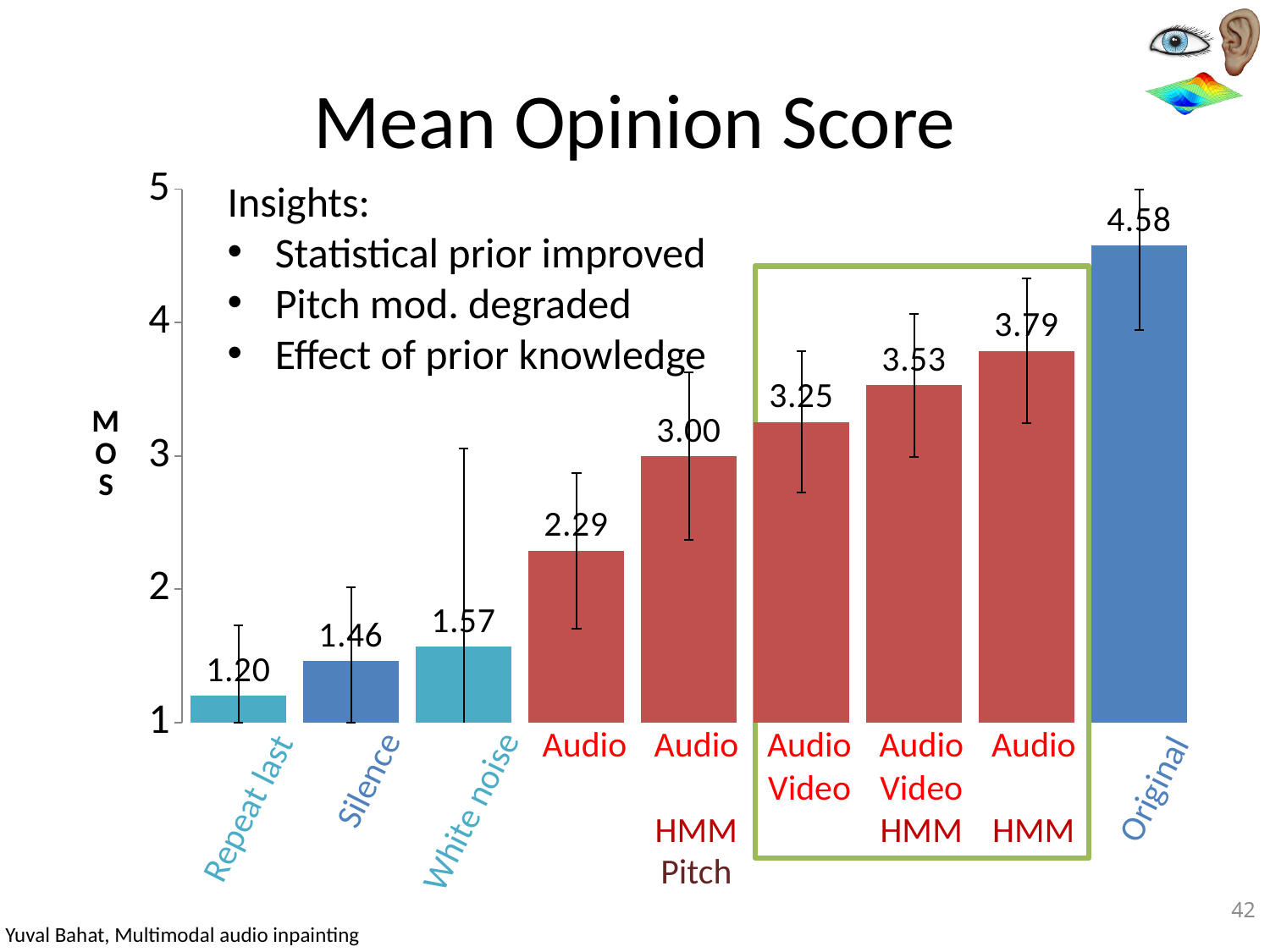
Which category has the lowest Mean Opinion Score? Repeat last Which category has the highest Mean Opinion Score? Original What is the difference between the Mean Opinion Score for Original and for Audio HMM? 0.79 Which has a higher Mean Opinion Score, Audio Video or Audio HMM Pitch? Audio Video How many bars are shown in the chart? 9 What kind of chart is shown on the slide? bar chart What is the label on the y axis of the chart? MOS What is the Mean Opinion Score for the Audio Video HMM condition? 3.53 What is the Mean Opinion Score for Silence? 1.46 Is the Mean Opinion Score for White noise greater or less than 2? less What is the Mean Opinion Score for Repeat last? 1.20 What is the Mean Opinion Score for Original? 4.58